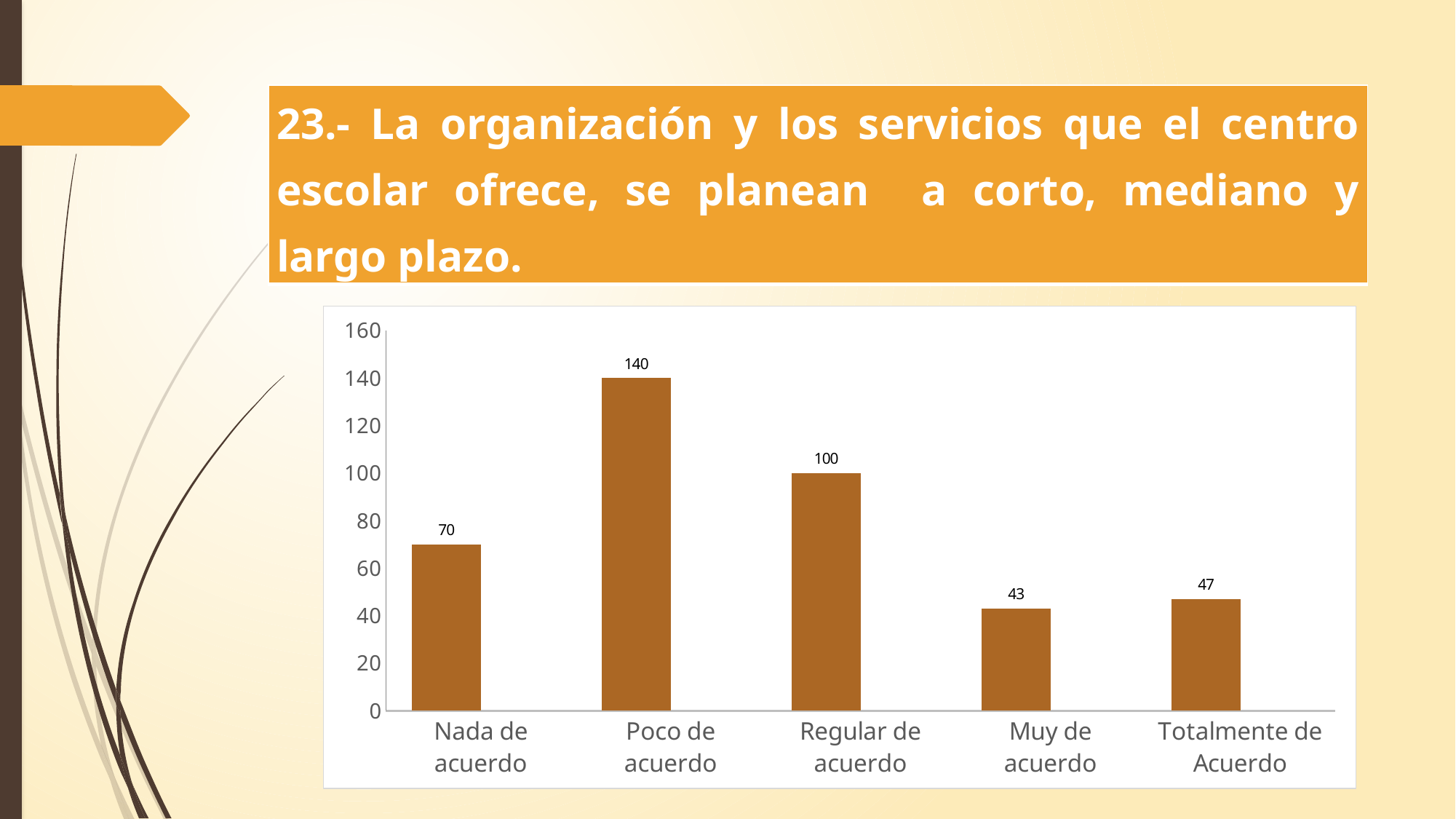
What is the difference between the values for "Poco de acuerdo" and "Regular de acuerdo"? 40 What is the difference between the values for "Nada de acuerdo" and "Muy de acuerdo"? 27 Which is larger, the value for "Nada de acuerdo" or the value for "Totalmente de Acuerdo"? Nada de acuerdo What is the value for "Muy de acuerdo"? 43 Which category has the highest value? Poco de acuerdo What kind of chart is shown on the slide? bar chart What is the highest value shown on the vertical axis? 160 Is the value for "Regular de acuerdo" greater or less than 120? less Which category has the lowest value? Muy de acuerdo What is the value for "Poco de acuerdo"? 140 What is the value for "Totalmente de Acuerdo"? 47 How many categories are shown on the x axis? 5